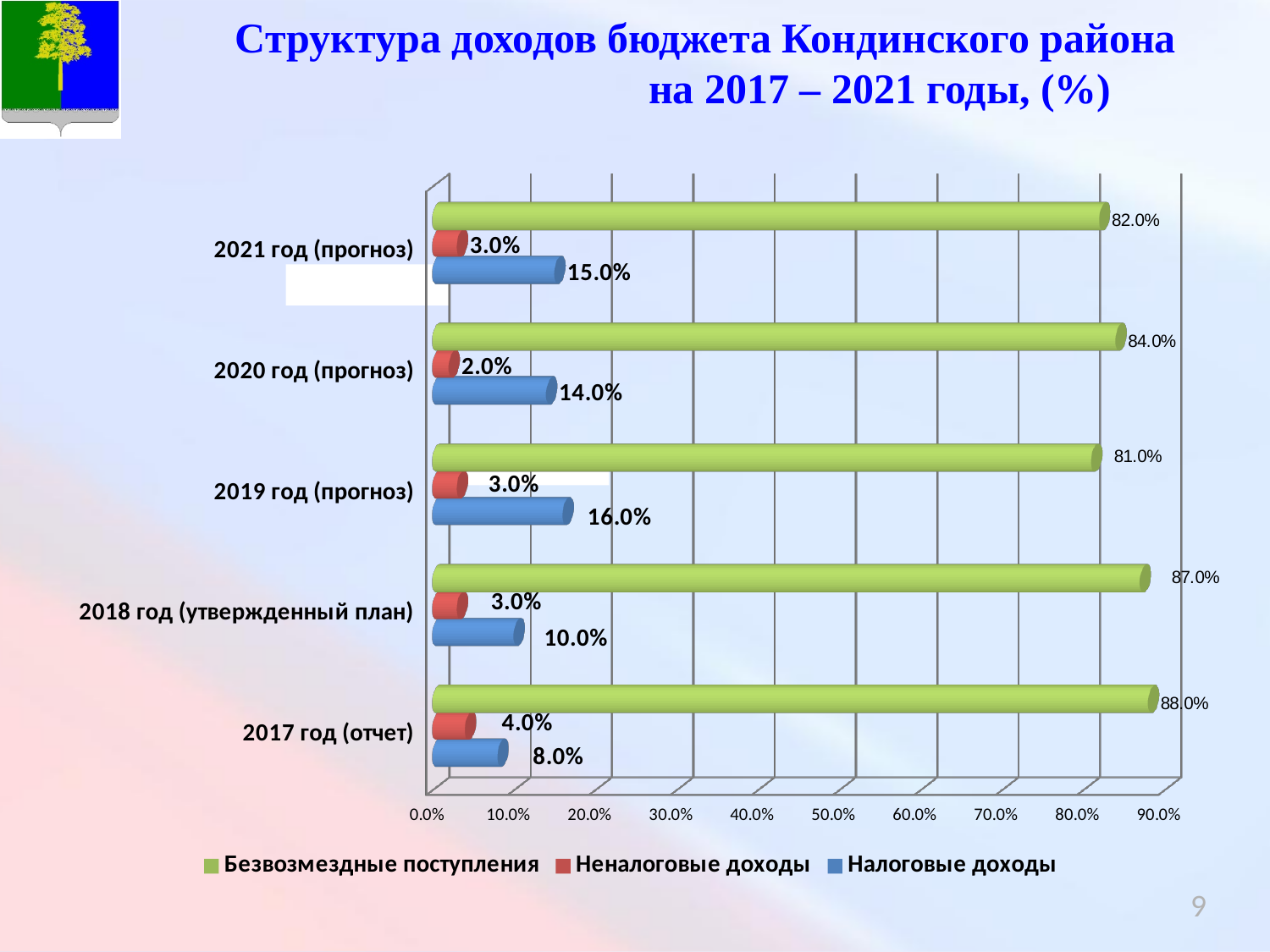
What is the value of Неналоговые доходы for 2020 год (прогноз)? 2.0% What is the value of Налоговые доходы for 2019 год (прогноз)? 16.0% Which category has the lowest value for Налоговые доходы? 2017 год (отчет) What kind of chart is shown on the slide? Bar chart How many series does the legend list? 3 Which colour represents Неналоговые доходы in the legend? Red How many categories (years) are shown on the chart? 5 Which category has the highest value for Безвозмездные поступления? 2017 год (отчет) What is the difference between Налоговые доходы for 2021 год (прогноз) and 2018 год (утвержденный план)? 5.0% What is the value of Безвозмездные поступления for 2017 год (отчет)? 88.0% What is the total of the three series for 2018 год (утвержденный план)? 100.0% Which is larger: Безвозмездные поступления for 2020 год (прогноз) or for 2019 год (прогноз)? 2020 год (прогноз)